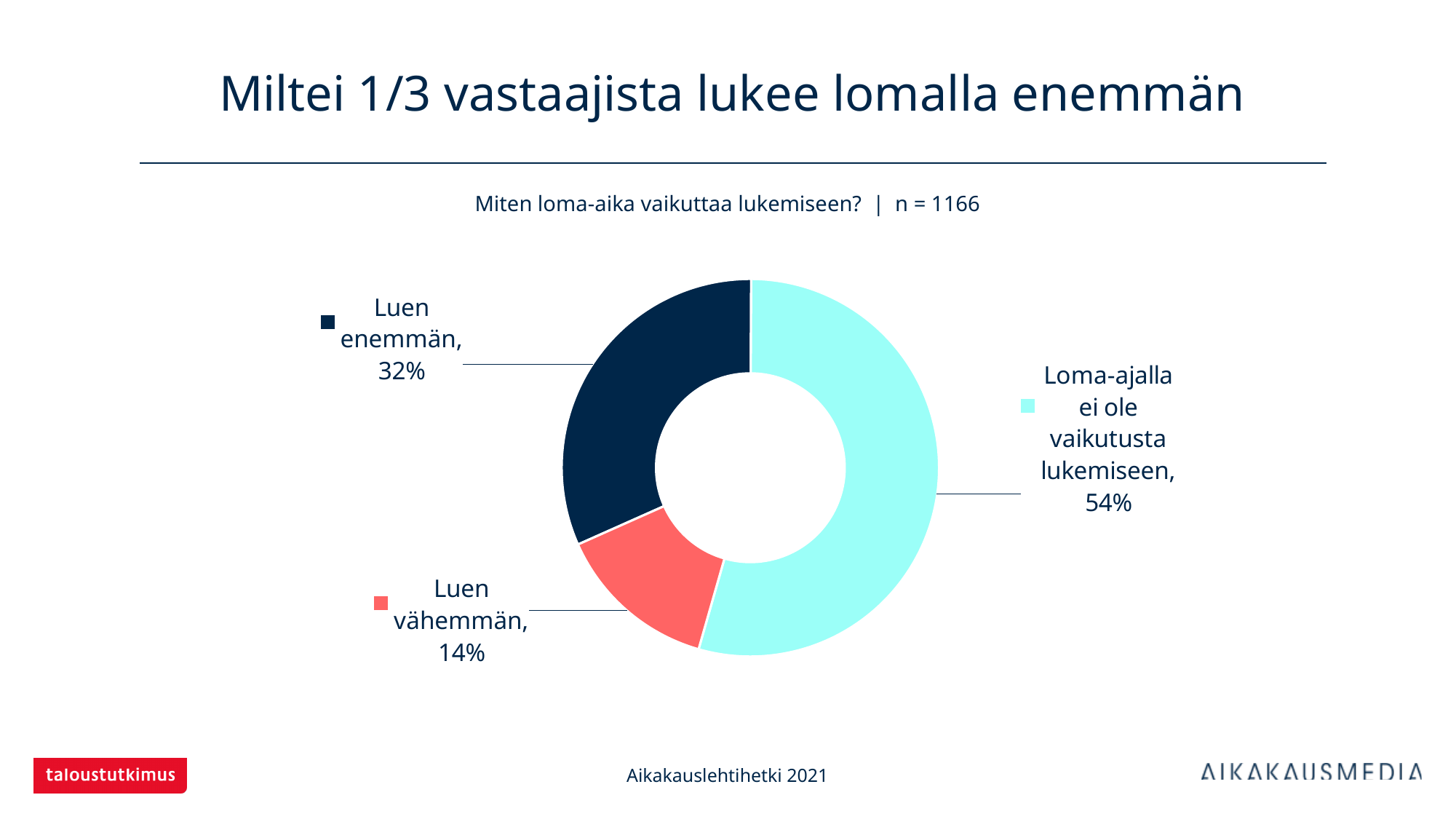
What is the difference in percentage points between "Loma-ajalla ei ole vaikutusta lukemiseen" and "Luen enemmän"? 22 What is the sample size (n) stated above the chart? 1166 What share of respondents answered "Luen enemmän"? 32% What kind of chart is shown on the slide? Doughnut (pie) chart How many categories are shown in the chart? 3 Which category has the largest share of the chart? Loma-ajalla ei ole vaikutusta lukemiseen Which category has the smallest share of the chart? Luen vähemmän What share of respondents answered "Luen vähemmän"? 14% What is the difference in percentage points between "Luen enemmän" and "Luen vähemmän"? 18 What share of respondents answered "Loma-ajalla ei ole vaikutusta lukemiseen"? 54% What colour is the slice for "Luen vähemmän"? Red (coral) Which is larger: the share for "Luen enemmän" or the share for "Luen vähemmän"? Luen enemmän